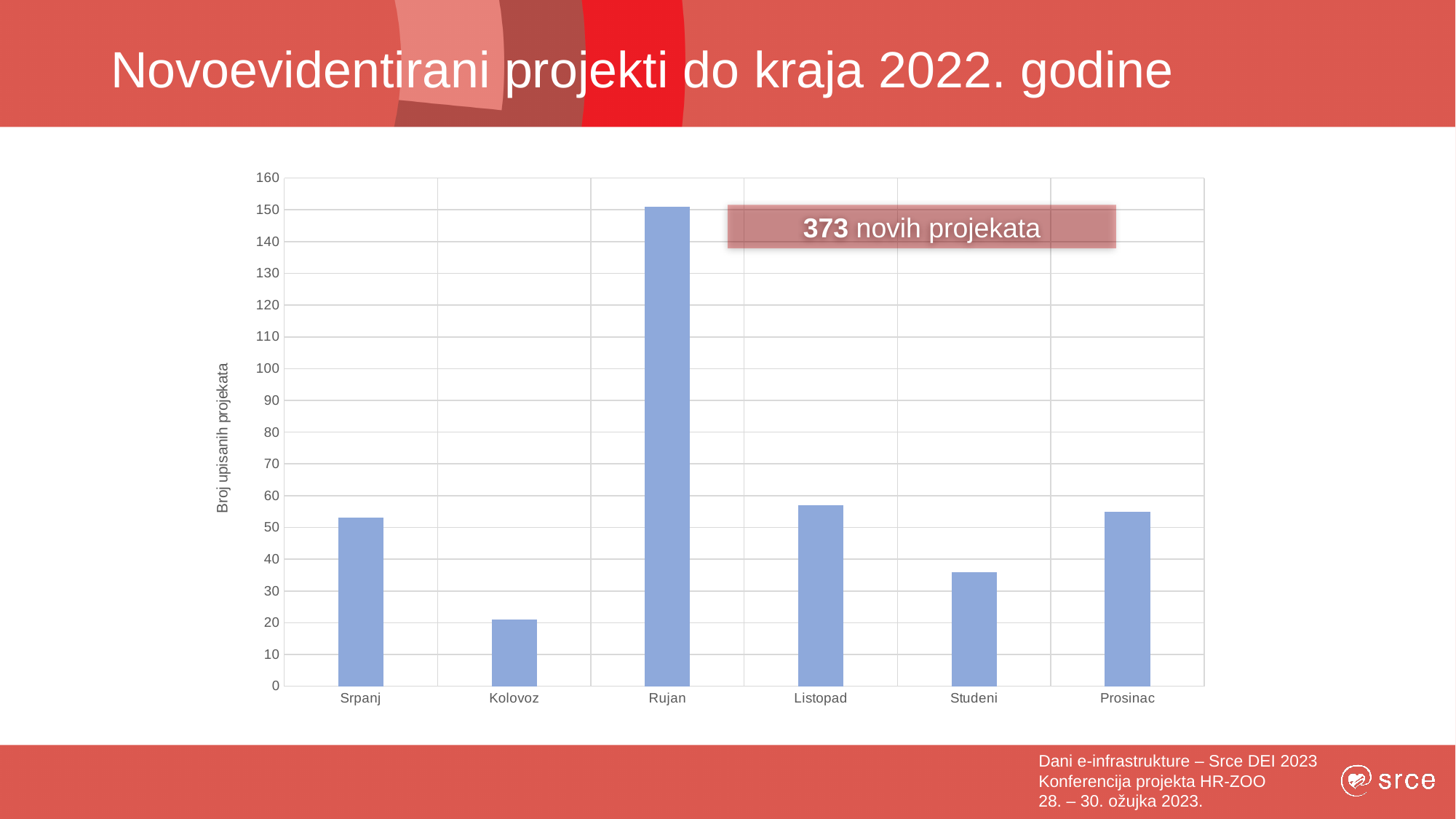
Is the value for Prosinac greater or less than 50? greater According to the text box on the chart, how many new projects were registered in total? 373 Is the value for Srpanj greater or less than 60? less Which month has the lowest number of registered projects in the chart? Kolovoz Which is larger, the value for Listopad or the value for Studeni? Listopad What kind of chart is shown on the slide? bar chart What is the label on the vertical axis of the chart? Broj upisanih projekata Which month has the highest number of registered projects in the chart? Rujan How many months (categories) are shown on the x axis of the chart? 6 Is the value for Kolovoz greater or less than 30? less